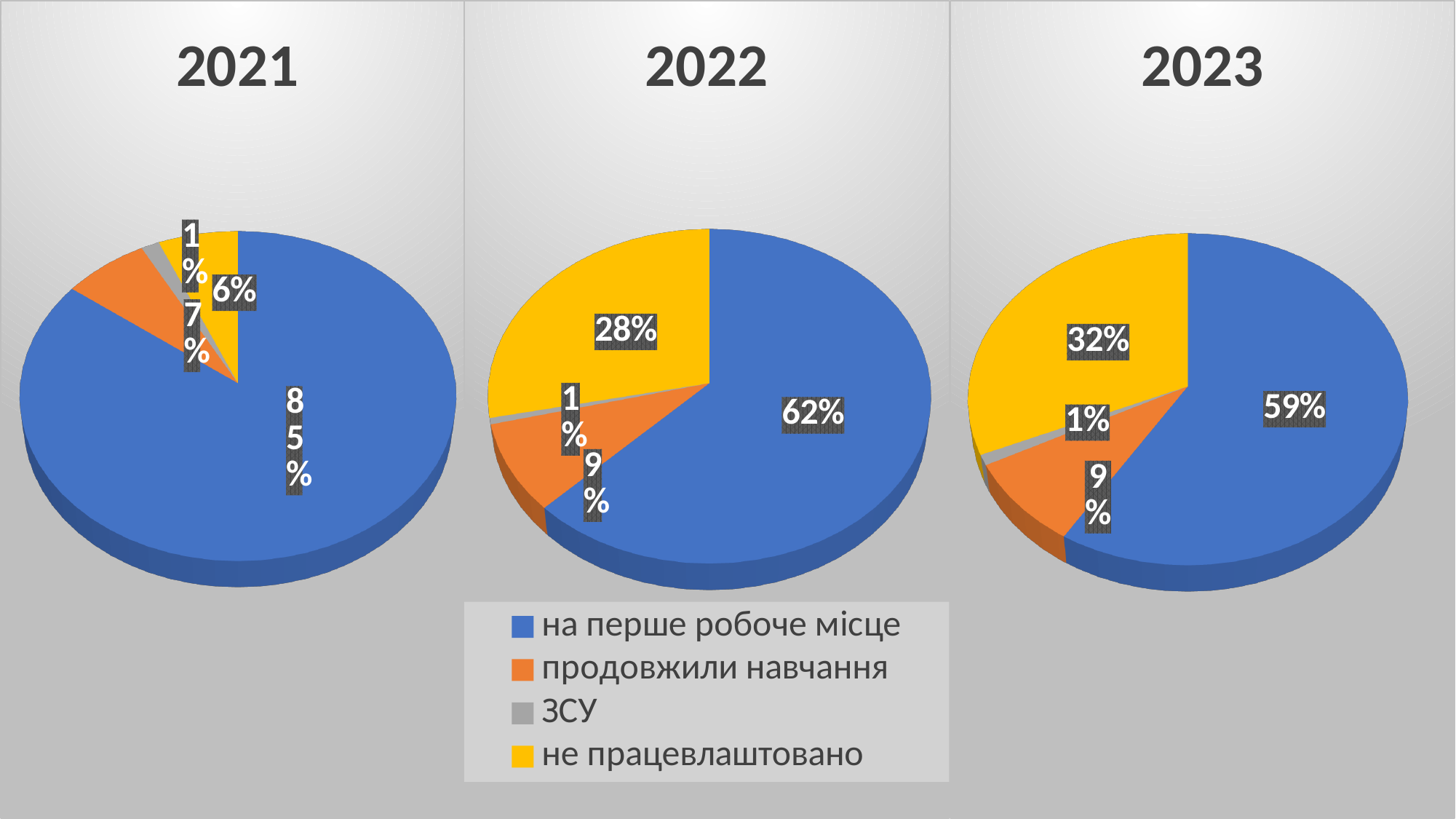
In the 2021 pie chart, which category has the smallest slice? ЗСУ How many categories does the legend list? 4 Which colour represents 'не працевлаштовано' in the legend? Yellow In the 2023 pie chart, what share is labelled for 'ЗСУ'? 1% In the 2022 pie chart, what share is labelled for 'не працевлаштовано'? 28% Which is larger: the 'на перше робоче місце' share in 2021 or in 2023? 2021 What is the difference between the 'не працевлаштовано' share in 2023 and in 2022? 4 percentage points In the 2021 pie chart, what share is labelled for 'на перше робоче місце'? 85% What kind of chart is used for the 2022 data? Pie chart In the 2022 pie chart, which category has the largest slice? на перше робоче місце In the 2023 pie chart, what share is labelled for 'продовжили навчання'? 9% How many pie charts are shown on the slide? 3